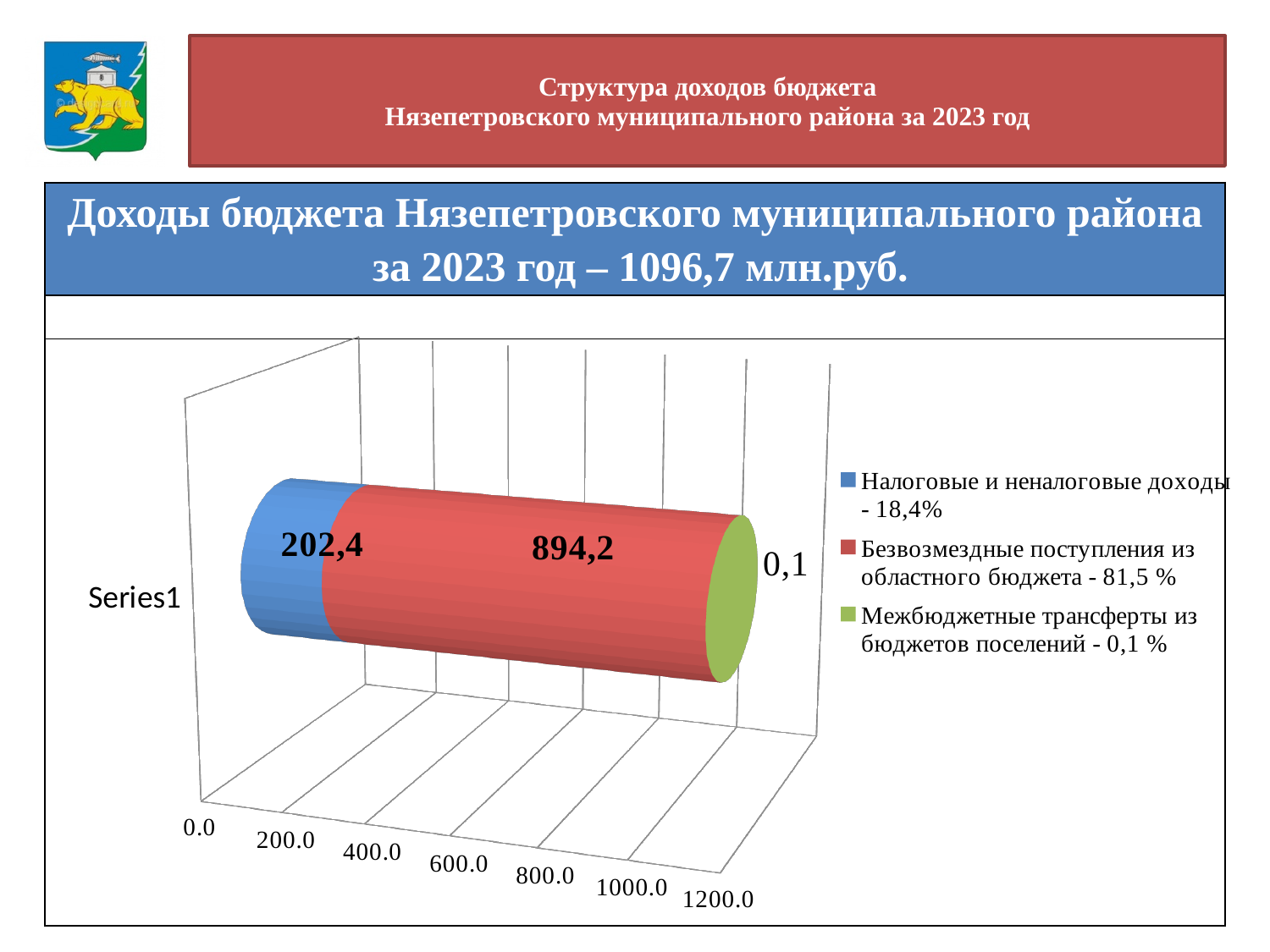
What is the total of the stacked bar for Series1? 1096,7 What is the value shown for Межбюджетные трансферты из бюджетов поселений? 0,1 How many series does the legend list? 3 Which series has the smallest value in the bar? Межбюджетные трансферты из бюджетов поселений What is the value shown for Безвозмездные поступления из областного бюджета? 894,2 What is the value shown for Налоговые и неналоговые доходы? 202,4 What is the difference between the values for Безвозмездные поступления из областного бюджета and Налоговые и неналоговые доходы? 691,8 What kind of chart is shown on the slide? Stacked bar chart Which is larger: the value for Налоговые и неналоговые доходы or the value for Безвозмездные поступления из областного бюджета? Безвозмездные поступления из областного бюджета Which series has the largest value in the bar? Безвозмездные поступления из областного бюджета What colour represents Безвозмездные поступления из областного бюджета in the chart? Red What percentage share does the legend give for Налоговые и неналоговые доходы? 18,4%